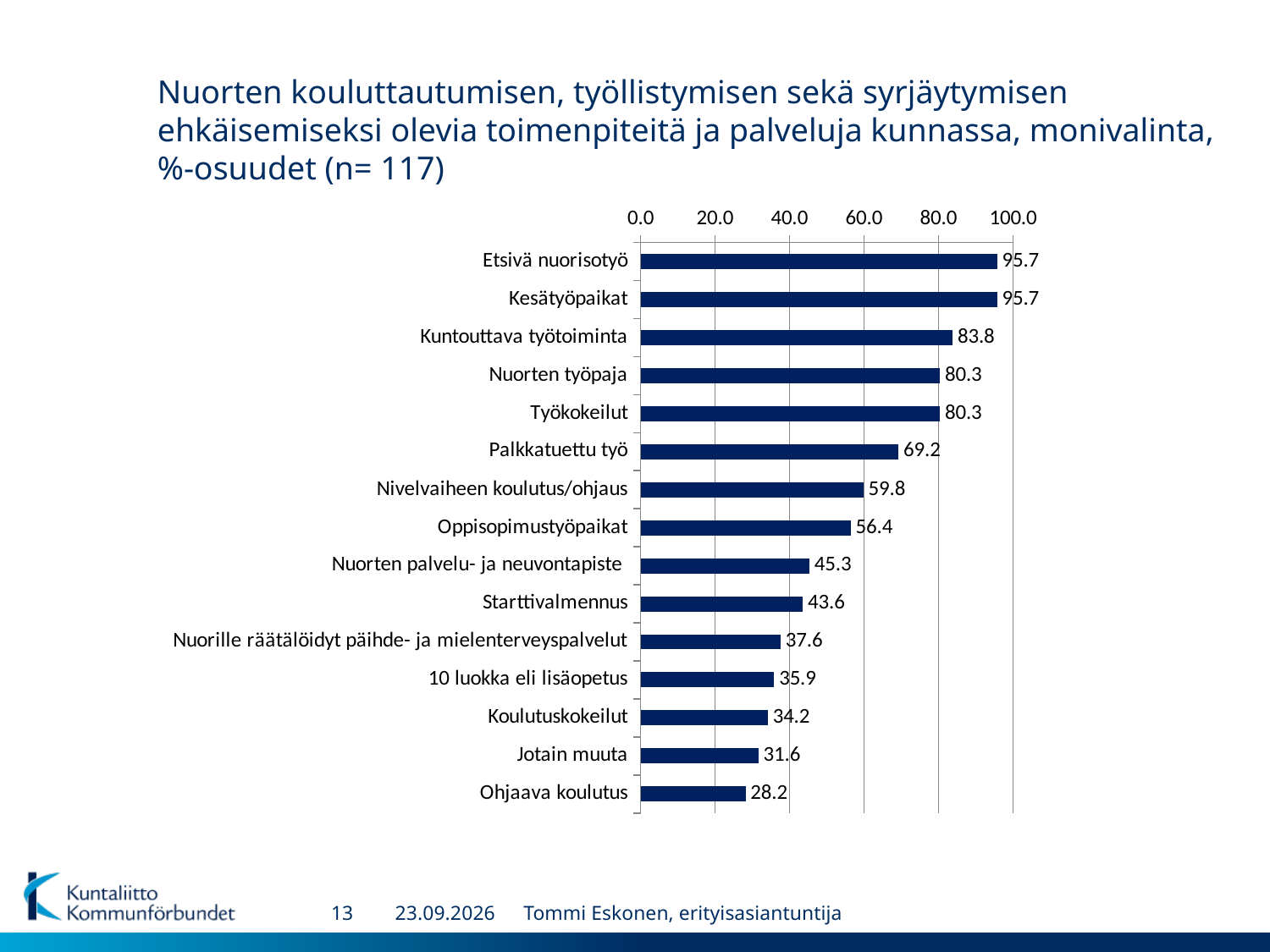
What is the value for Nuorille räätälöidyt päihde- ja mielenterveyspalvelut? 37.6 What kind of chart is shown on the slide? bar chart Is the value for Jotain muuta greater or less than 40.0? less What is the value for Palkkatuettu työ? 69.2 What is the difference between the values for Oppisopimustyöpaikat and Nuorten palvelu- ja neuvontapiste? 11.1 Which category has the lowest value? Ohjaava koulutus What is the difference between the values for Etsivä nuorisotyö and Ohjaava koulutus? 67.5 What is the sample size (n) stated in the chart title? 117 How many categories are shown in the chart? 15 Which is larger, the value for Nivelvaiheen koulutus/ohjaus or the value for Koulutuskokeilut? Nivelvaiheen koulutus/ohjaus What is the value for Kuntouttava työtoiminta? 83.8 What is the value for Starttivalmennus? 43.6